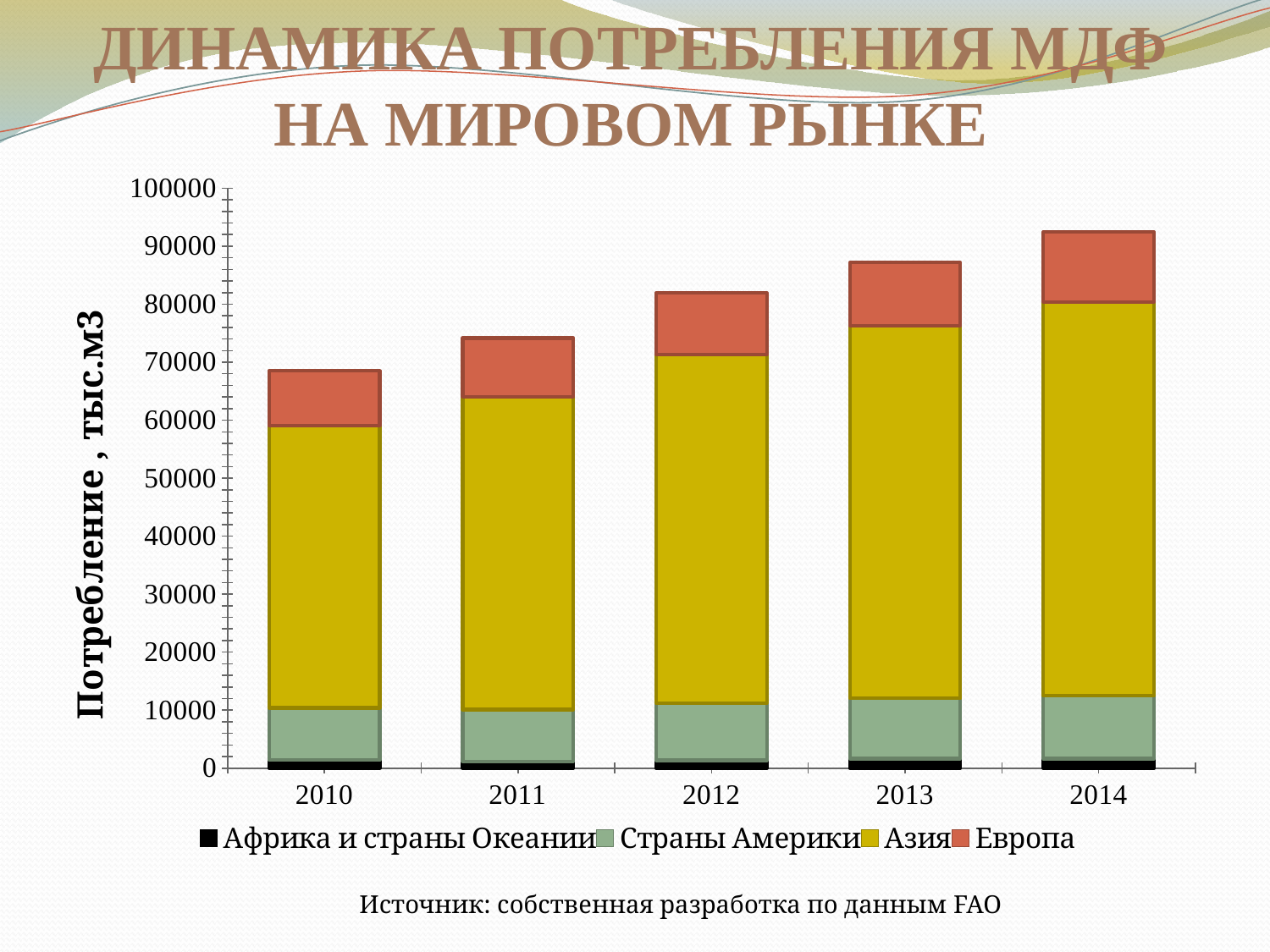
Which series occupies the largest portion of each stacked bar? Азия Which year has the larger total consumption, 2011 or 2013? 2013 How many series does the chart legend list? 4 Which year has the highest total MDF consumption in the chart? 2014 What is the label on the vertical axis of the chart? Потребление , тыс.м3 Do the total bar heights rise or fall from 2010 to 2014? Rise What kind of chart is shown on the slide? Stacked bar chart Which year has the lowest total MDF consumption in the chart? 2010 Is the total consumption for 2010 greater or less than 70000? less Is the total consumption for 2013 greater or less than 80000? greater Is the total consumption for 2014 greater or less than 90000? greater How many years are shown on the x axis of the chart? 5